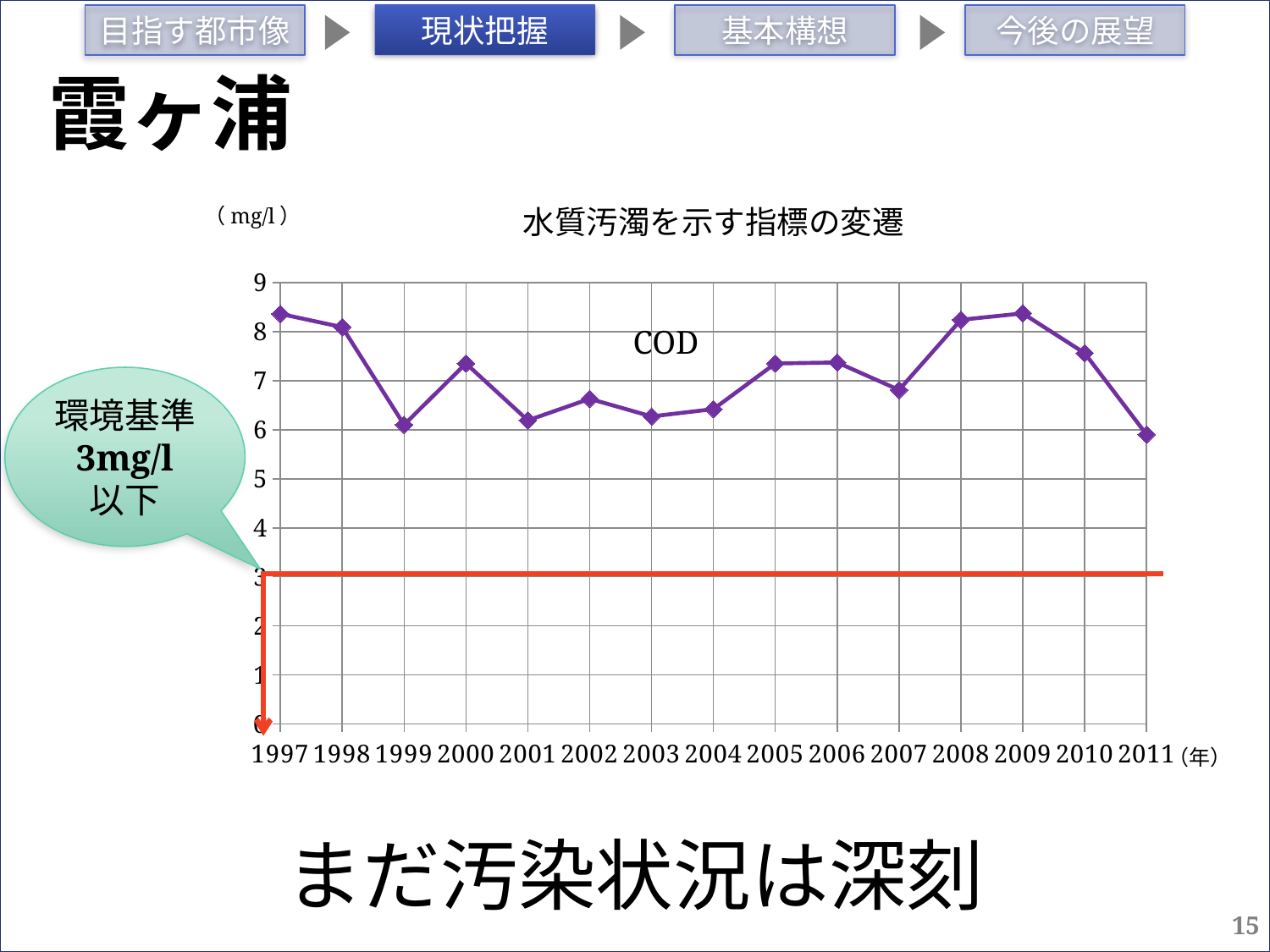
Is the COD value for 2011 greater or less than 7? less How many data series are plotted on the chart? 1 Is the COD value for 1997 greater or less than 8? greater Is the COD value for 2008 greater or less than 8? greater What unit is shown for the vertical axis of the chart? mg/l Does the COD value rise or fall from 2009 to 2011? fall What is the title of the chart? 水質汚濁を示す指標の変遷 How many years (data points) are plotted on the chart? 15 What kind of chart is shown on the slide? line chart Which year has the higher COD value, 2007 or 2008? 2008 Which year has the higher COD value, 1997 or 1999? 1997